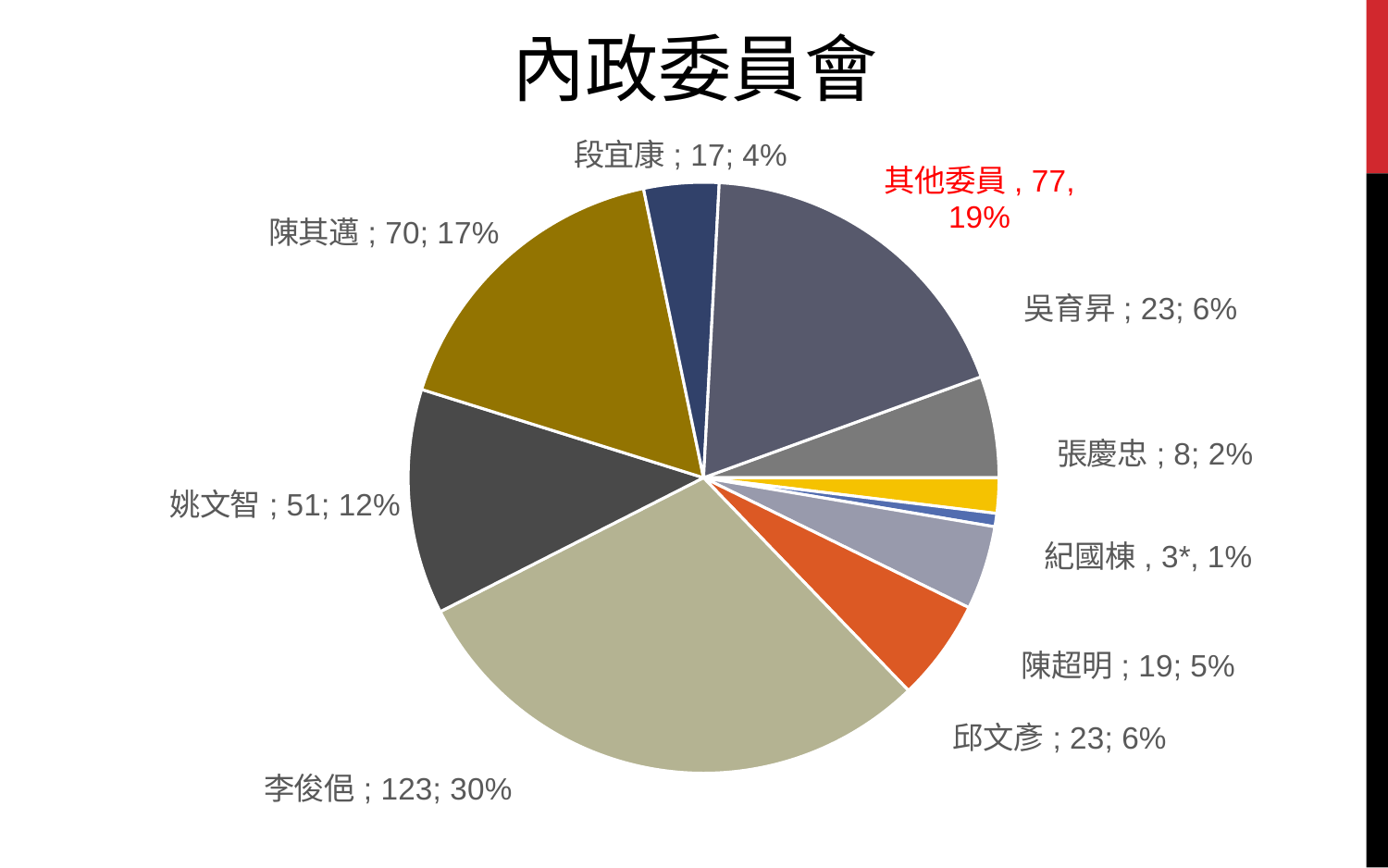
Which category has the largest slice? 李俊俋 What is the value shown for 姚文智? 51 How many slices does the pie chart have? 10 What percentage share does 其他委員 have? 19% Which is larger, the value for 陳其邁 or the value for 姚文智? 陳其邁 What percentage share does 陳其邁 have? 17% What type of chart is shown on the slide? pie chart What is the value shown for 張慶忠? 8 Which category has the smallest slice? 紀國棟 What is the value shown for 李俊俋? 123 What is the title of the chart? 內政委員會 What is the difference between the values for 李俊俋 and 其他委員? 46